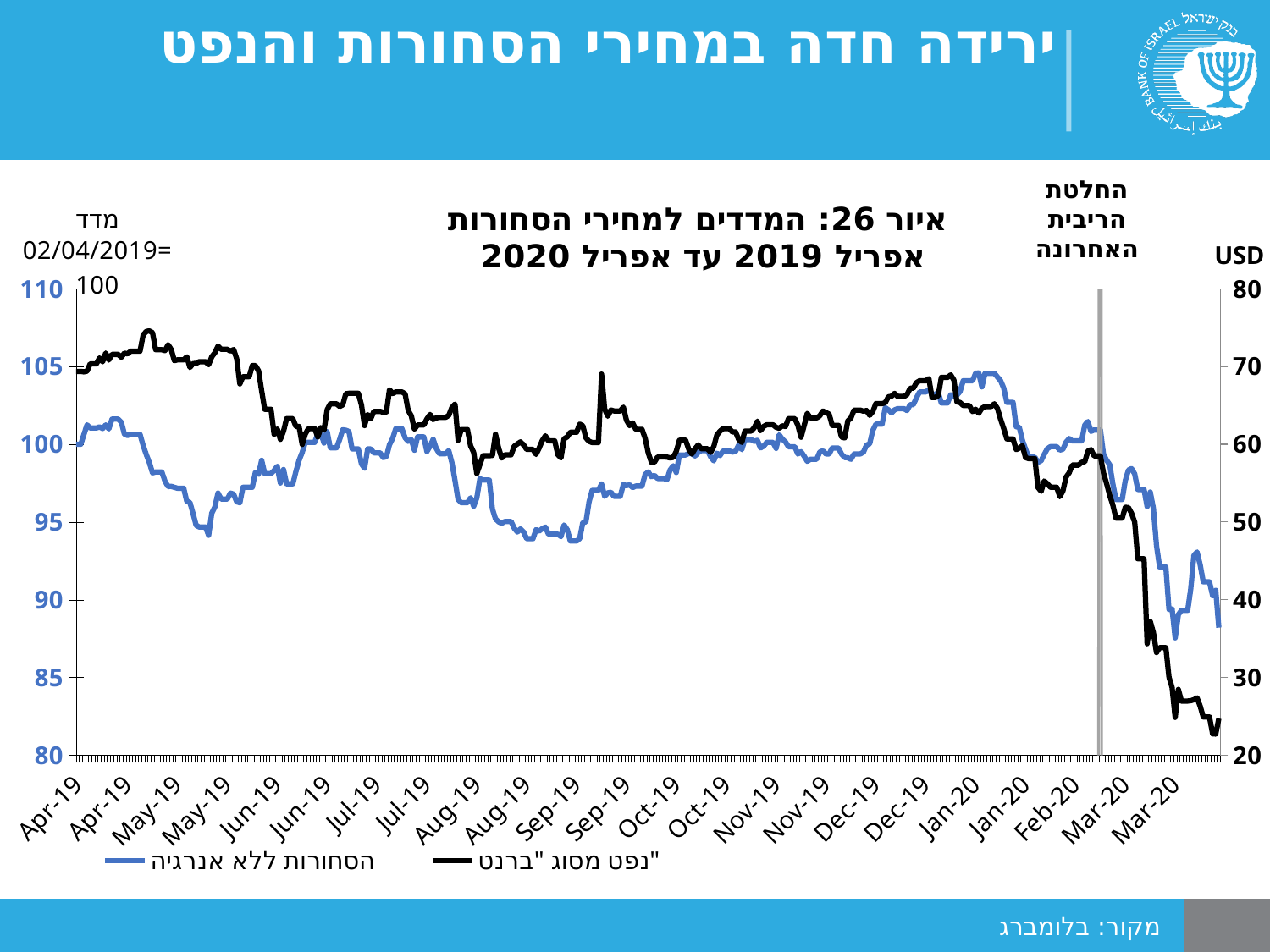
Does the Brent oil price (black line) rise or fall between Jan-20 and the end of Mar-20? Fall Is the non-energy commodities index (blue line) at its low point around Sep-19 greater or less than 95? less Is the Brent oil price (right axis, USD) at its peak in May-19 greater or less than 70? greater What kind of chart is shown on the slide? Line chart Is the Brent oil price (right axis, USD) at the start of Apr-19 greater or less than 60? greater What are the two series named in the legend? הסחורות ללא אנרגיה and נפט מסוג "ברנט" How many series does the legend list? 2 What event does the vertical grey line on the chart mark? החלטת הריבית האחרונה Does the non-energy commodities index (blue line) rise or fall from Apr-19 to mid May-19? Fall